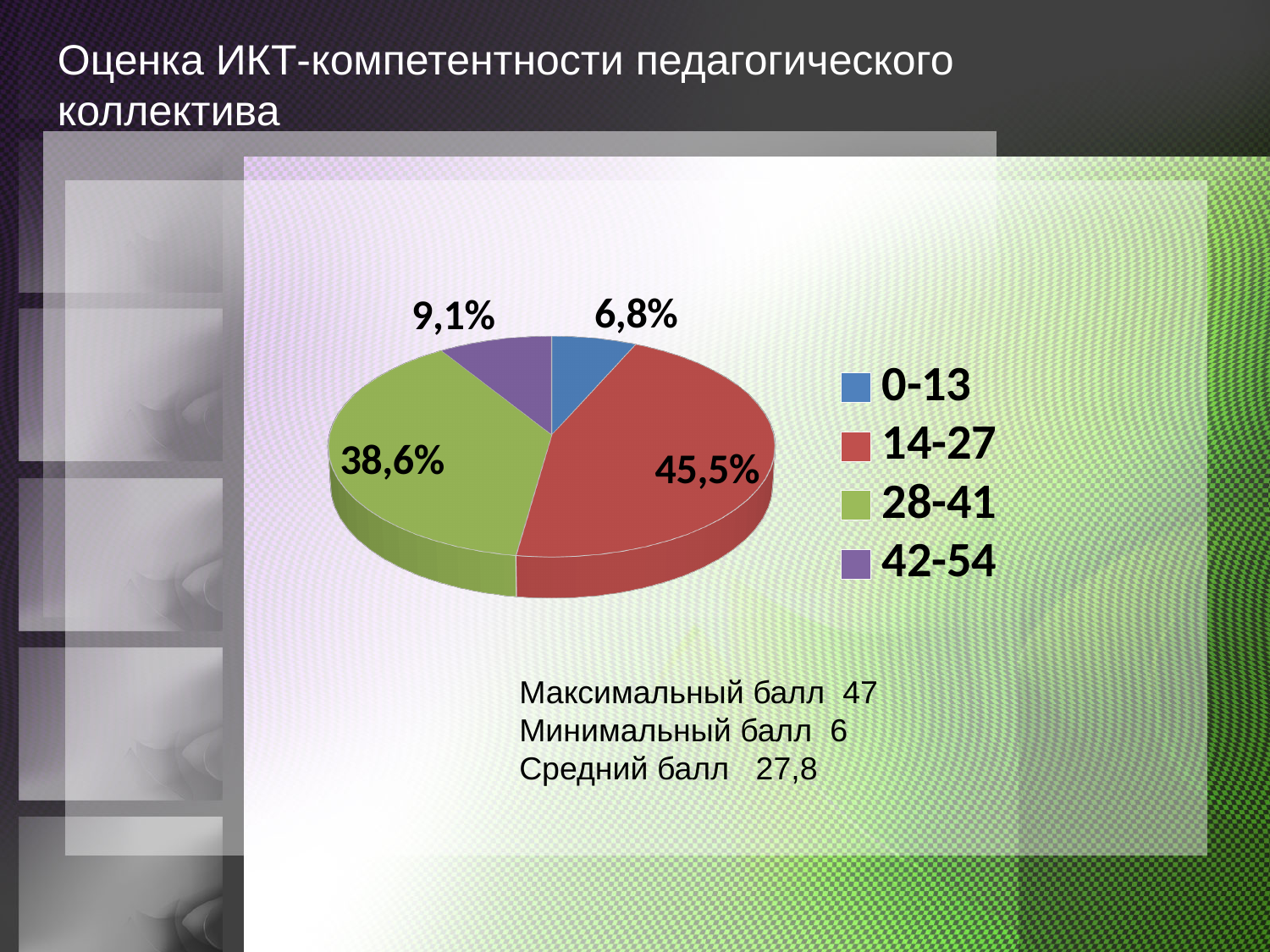
What is the difference in percentage points between the 14-27 and 28-41 slices? 6,9 What share of the pie does the 0-13 category have? 6,8% Which slice is larger, 42-54 or 0-13? 42-54 What share of the pie does the 14-27 category have? 45,5% Which category has the smallest slice of the pie? 0-13 What share of the pie does the 28-41 category have? 38,6% What colour is the slice for the 28-41 category? Green What is the difference in percentage points between the 42-54 and 0-13 slices? 2,3 What kind of chart is shown on the slide? Pie chart What share of the pie does the 42-54 category have? 9,1% Which category has the largest slice of the pie? 14-27 How many categories does the pie chart show? 4